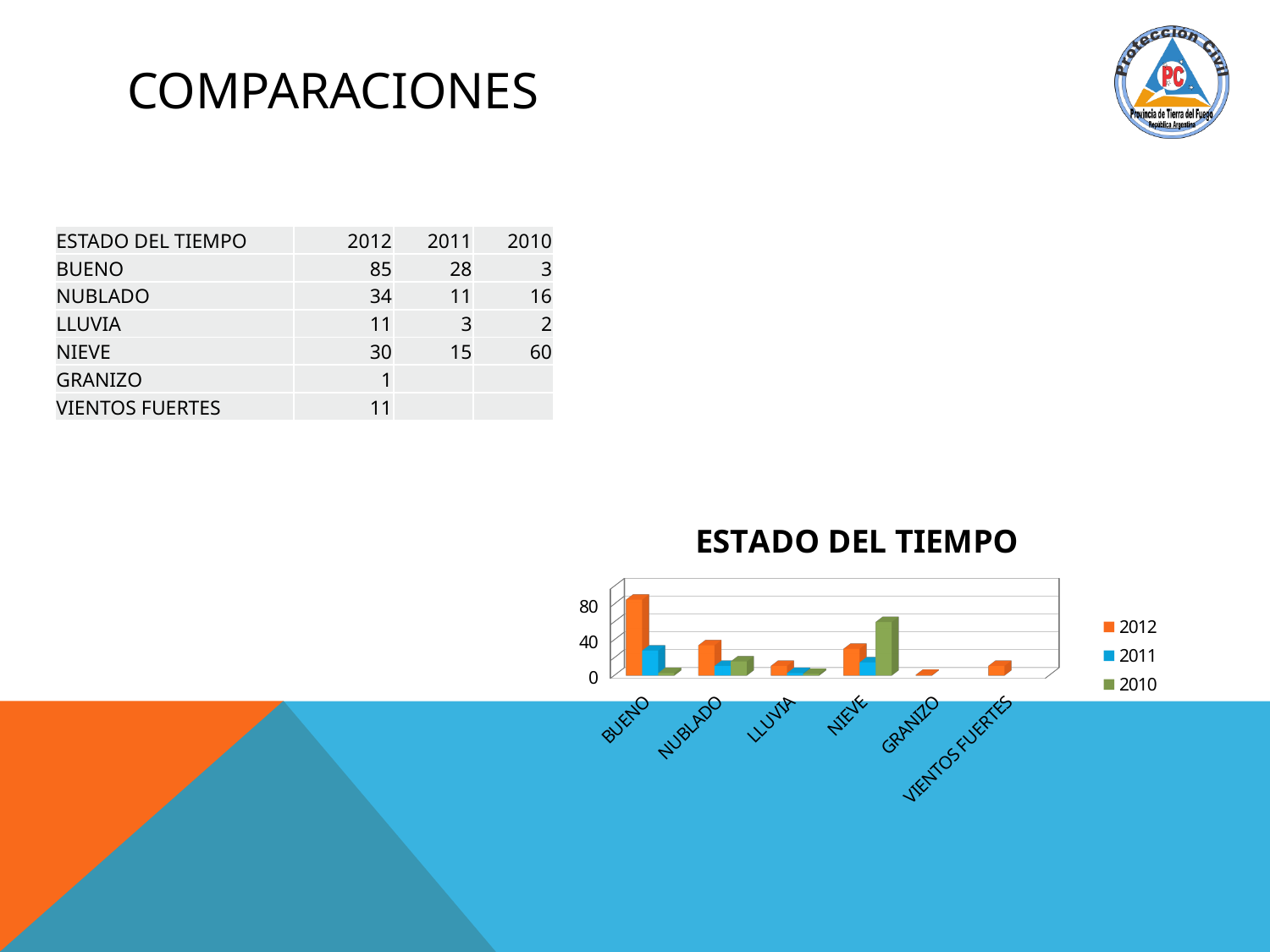
In the ESTADO DEL TIEMPO chart, is the 2012 value for BUENO greater or less than 40? greater What kind of chart is shown under the title ESTADO DEL TIEMPO? bar chart What is the difference between the 2012 and 2011 values for BUENO? 57 In the ESTADO DEL TIEMPO chart, which category has the highest value for 2010? NIEVE In the ESTADO DEL TIEMPO chart, is the 2012 value for LLUVIA greater or less than 40? less In the ESTADO DEL TIEMPO chart, which category has the highest value for 2012? BUENO For NIEVE, which year has the larger value, 2010 or 2012? 2010 How many series does the legend of the ESTADO DEL TIEMPO chart list? 3 How many weather categories are shown on the x axis of the ESTADO DEL TIEMPO chart? 6 Which colour represents the 2012 series in the ESTADO DEL TIEMPO chart? orange What is the value for BUENO in 2012? 85 What is the value for NIEVE in 2010? 60